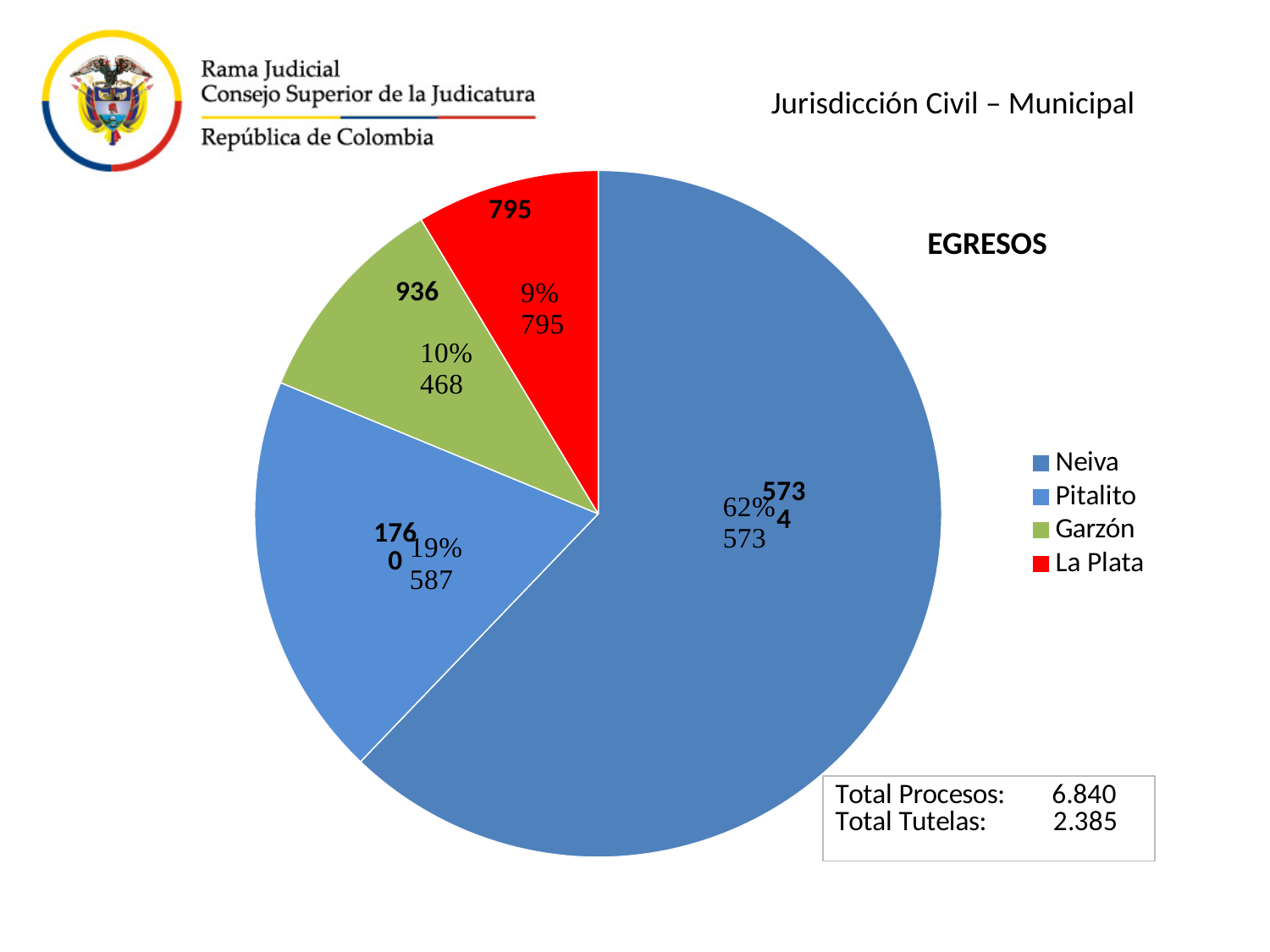
What kind of chart is shown on the slide? pie chart What colour is the La Plata slice in the pie chart? red Which has a larger share of the pie, Pitalito or Garzón? Pitalito What percentage share of the pie does Neiva have? 62% How many entries does the legend list? 4 What percentage share of the pie does Garzón have? 10% What percentage share of the pie does La Plata have? 9% What is the title of the chart? EGRESOS Which category has the largest slice of the pie? Neiva How many slices does the pie chart have? 4 Which category has the smallest slice of the pie? La Plata